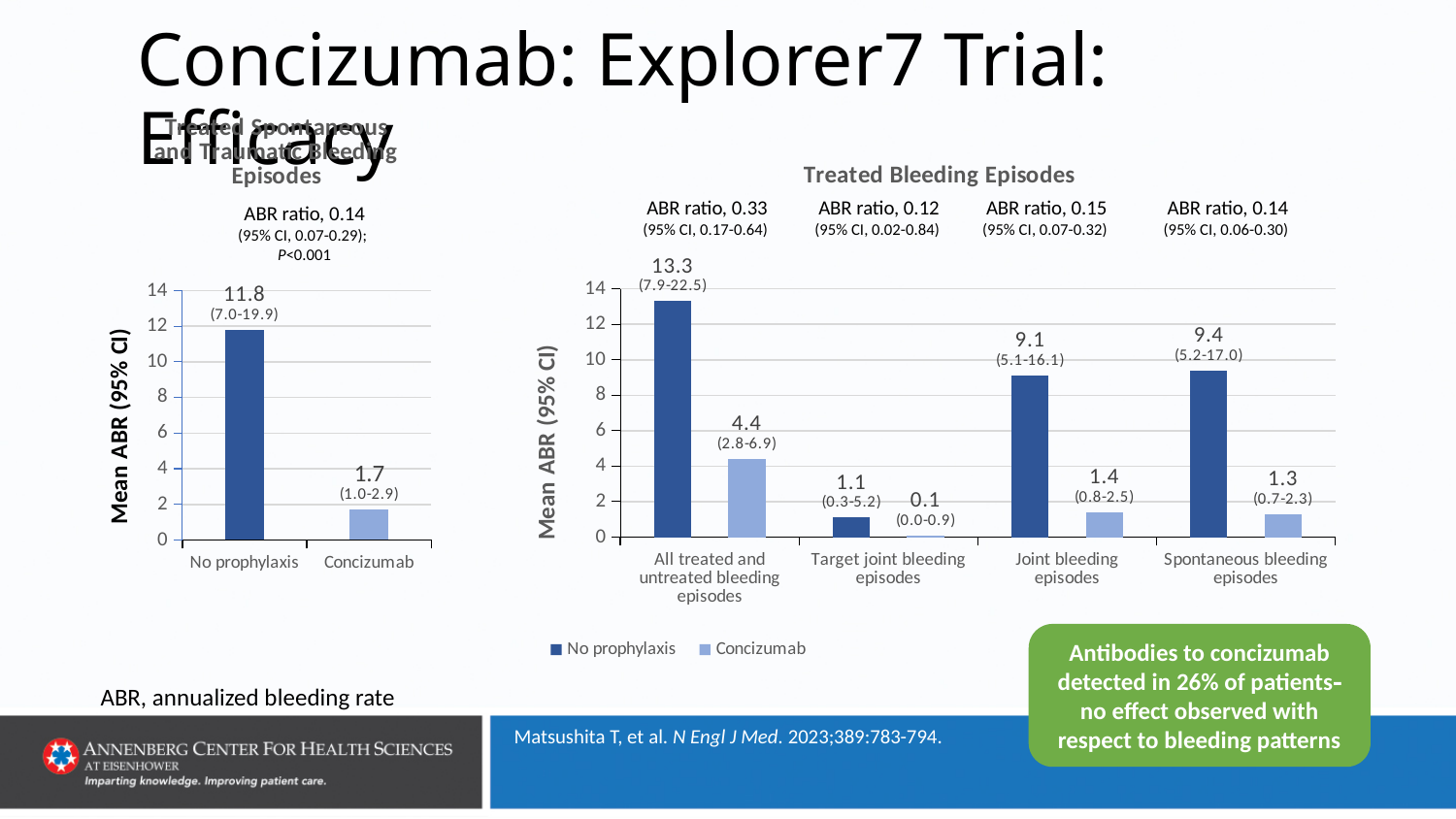
In the left chart, what is the mean ABR for No prophylaxis? 11.8 In the Treated Bleeding Episodes chart, what is the No prophylaxis value for All treated and untreated bleeding episodes? 13.3 In the left chart, what is the difference between the No prophylaxis and Concizumab values? 10.1 In the Treated Bleeding Episodes chart, what is the Concizumab value for Joint bleeding episodes? 1.4 In the Treated Bleeding Episodes chart, which category has the lowest Concizumab value? Target joint bleeding episodes In the Treated Bleeding Episodes chart, which category has the highest No prophylaxis value? All treated and untreated bleeding episodes In the Treated Bleeding Episodes chart, what is the Concizumab value for Target joint bleeding episodes? 0.1 What type of chart is the Treated Bleeding Episodes chart? Bar chart In the Treated Bleeding Episodes chart, how many series does the legend list? 2 In the left chart, what is the mean ABR for Concizumab? 1.7 In the Treated Bleeding Episodes chart, how many categories are shown on the x axis? 4 In the Treated Bleeding Episodes chart, what is the difference between the No prophylaxis and Concizumab values for Spontaneous bleeding episodes? 8.1